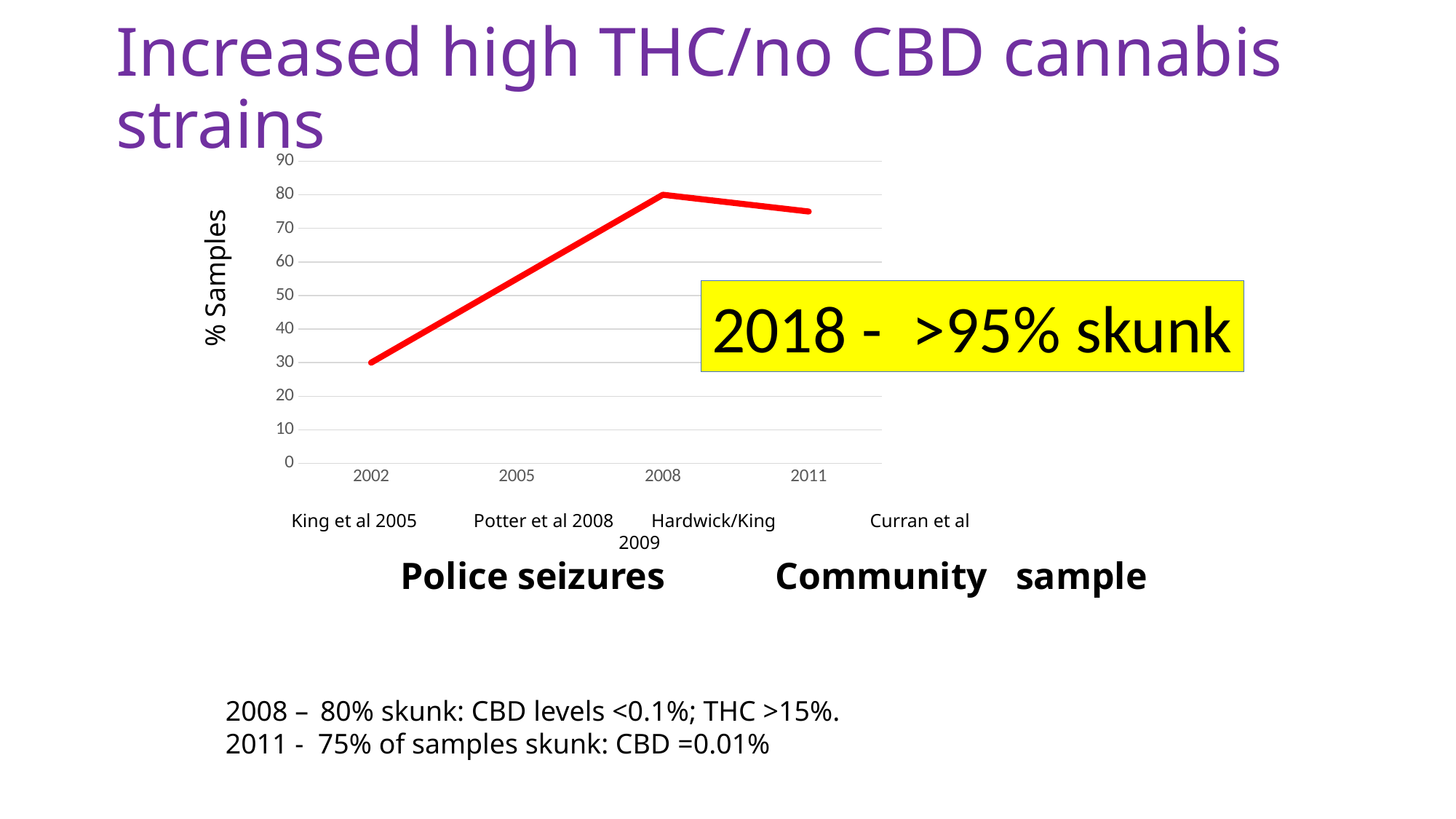
What is the % Samples value for 2008? 80 Does the line rise or fall between 2002 and 2008? rise What is the difference between the % Samples values for 2008 and 2011? 5 What is the % Samples value for 2002? 30 What kind of chart is shown on the slide? line chart Which year has the highest % Samples value? 2008 What is the % Samples value for 2011? 75 Which year has the larger % Samples value, 2002 or 2011? 2011 What is the label on the vertical axis of the chart? % Samples Is the value for 2002 greater or less than 40? less Which year has the lowest % Samples value? 2002 How many years are labelled on the x axis of the chart? 4